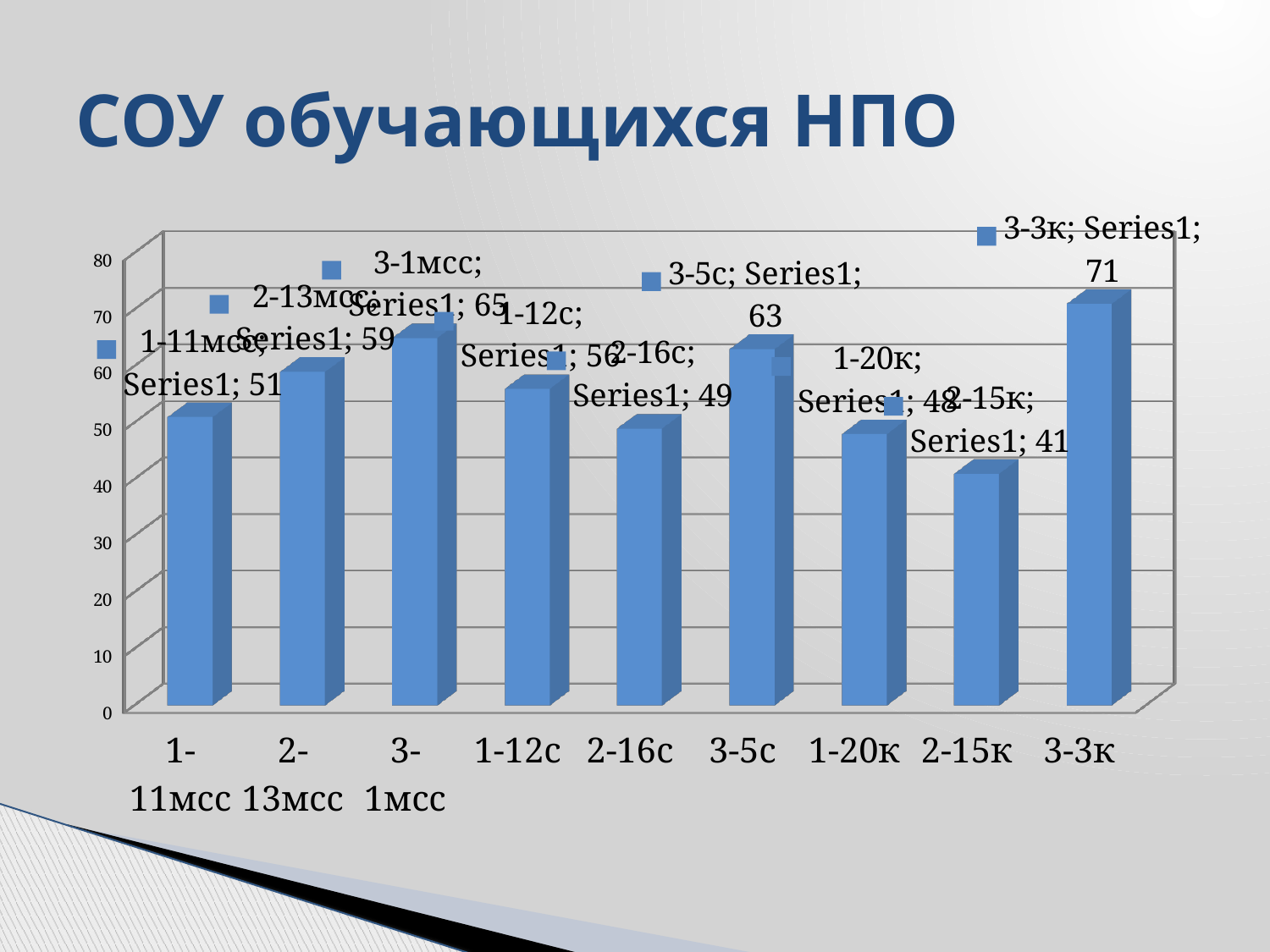
Is the value for 3-3к greater or less than 70? greater What is the difference between the values for 3-1мсс and 2-13мсс? 6 What is the value for 3-5с? 63 Which category has the lowest value? 2-15к What is the value for 1-11мсс? 51 What is the value for 3-3к? 71 What is the title of the slide? СОУ обучающихся НПО What kind of chart is shown on the slide? bar chart Which is larger, the value for 2-16с or the value for 3-5с? 3-5с How many categories are shown on the x axis? 9 What is the value for 2-15к? 41 Which category has the highest value? 3-3к